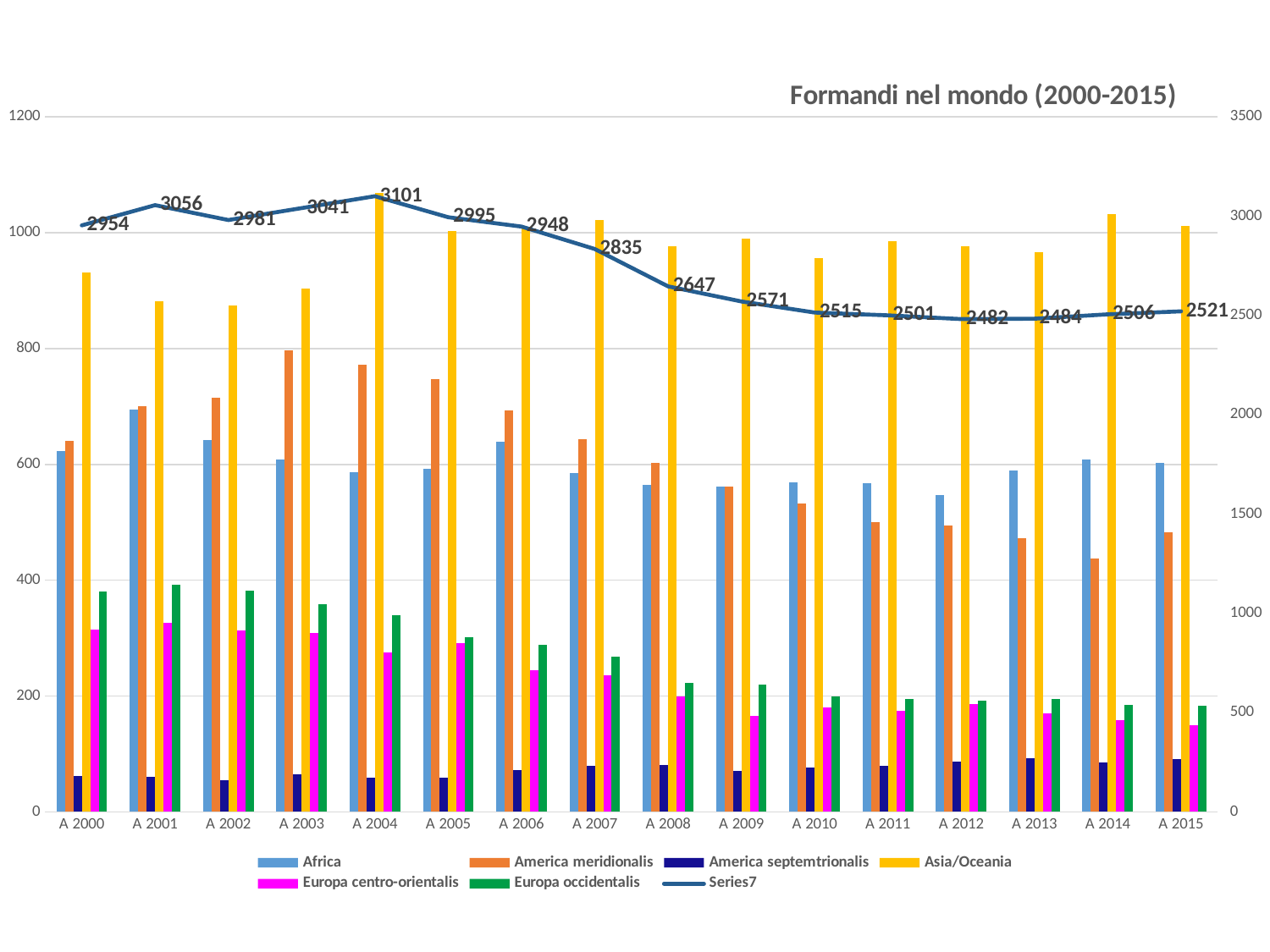
What is the difference between the Series7 values for A 2004 and A 2012? 619 How many series does the legend list? 7 What is the title of the chart? Formandi nel mondo (2000-2015) What is the value of Series7 at A 2004? 3101 Which year has the larger Series7 value, A 2001 or A 2003? A 2001 In which year does Series7 reach its highest value? A 2004 Is the Asia/Oceania bar for A 2004 greater or less than 1000 on the left axis? greater Is the America septemtrionalis bar for A 2000 greater or less than 200 on the left axis? less What is the value of Series7 at A 2015? 2521 In which year does Series7 reach its lowest value? A 2012 What is the difference between the Series7 values for A 2000 and A 2015? 433 How many years are shown on the x axis? 16